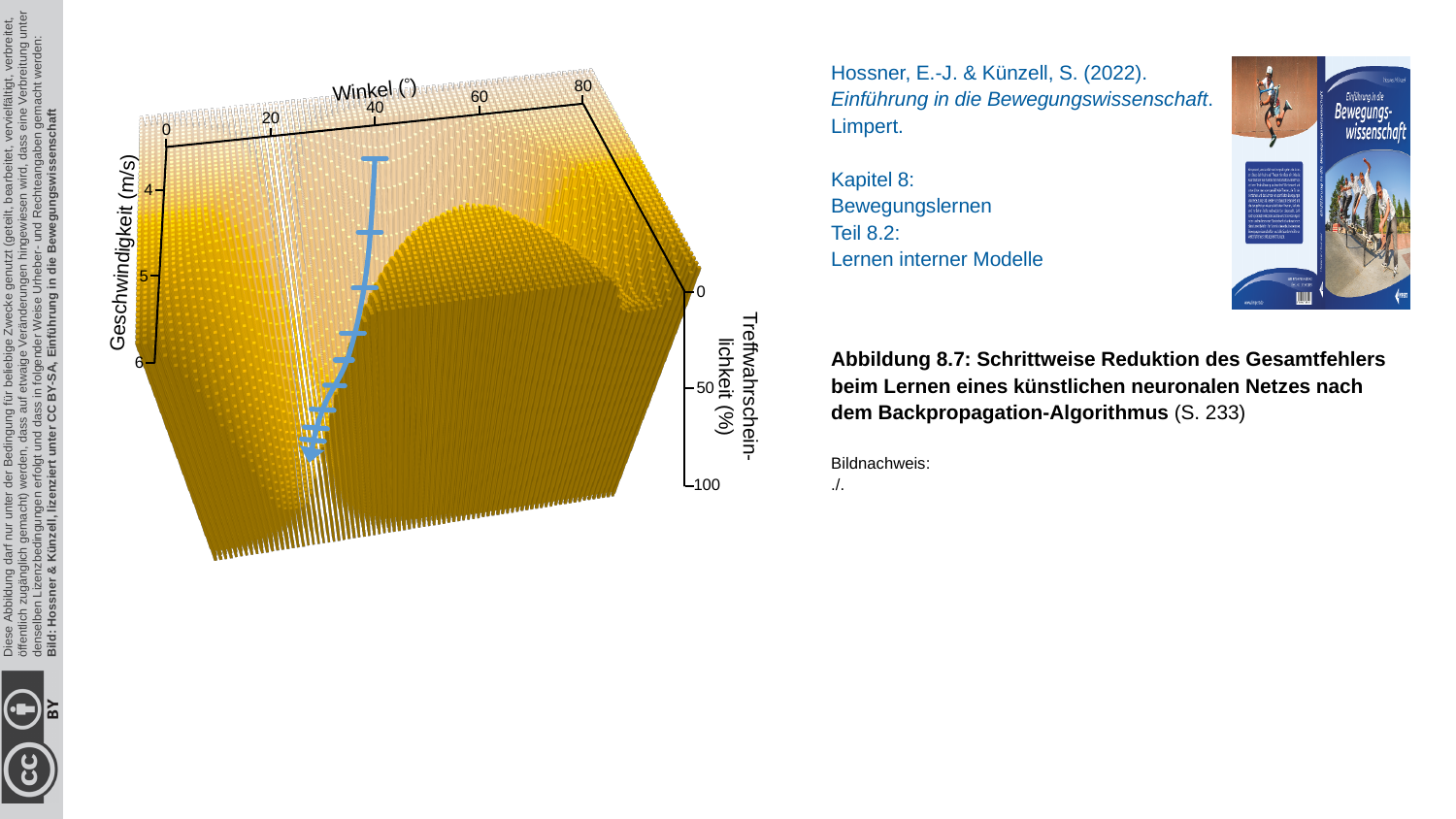
What is the highest tick value shown on the Geschwindigkeit (m/s) axis? 6 How many tick labels are shown on the Winkel (°) axis? 5 What is the figure number given in the caption for this chart? Abbildung 8.7 What kind of chart is shown on the slide? 3D surface chart What is the lowest tick value shown on the Geschwindigkeit (m/s) axis? 4 What is the highest tick value shown on the Winkel (°) axis? 80 How many tick labels are shown on the Treffwahrscheinlichkeit (%) axis? 3 What is the difference between the highest and lowest tick values on the Treffwahrscheinlichkeit (%) axis? 100 What is the label of the horizontal axis at the top of the chart? Winkel (°) What is the label of the vertical axis on the right side of the chart? Treffwahrscheinlichkeit (%)